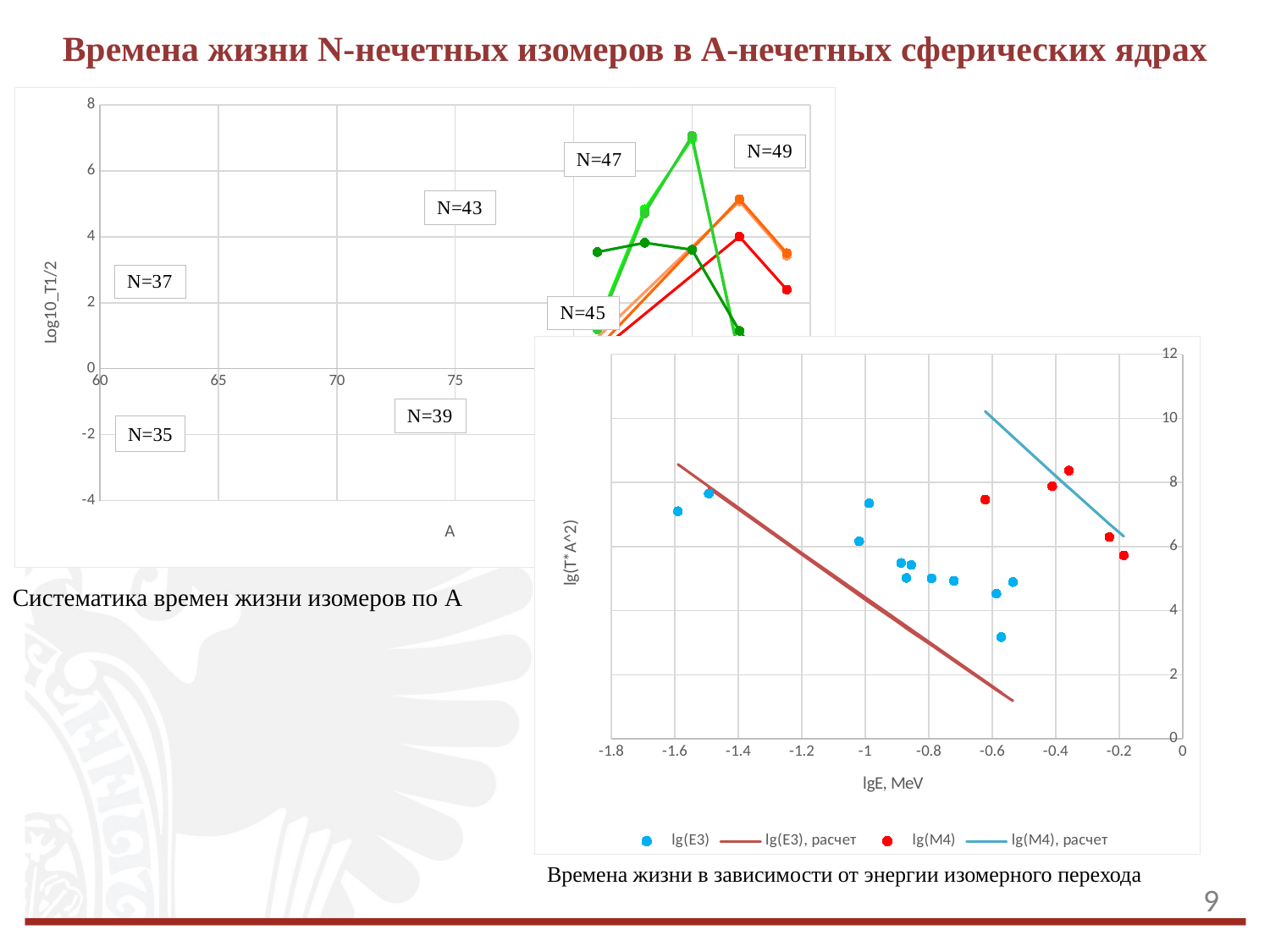
In the bottom-right chart, what is the title of the x axis? lgE, MeV What kind of chart is the top-left chart 'Систематика времен жизни изомеров по A'? line chart In the bottom-right chart, how many red lg(M4) data points are plotted? 5 What kind of chart is the bottom-right chart titled 'Времена жизни в зависимости от энергии изомерного перехода'? scatter chart In the top-left chart, is the highest point of the bright green line greater or less than 6? greater In the bottom-right chart, is the lowest blue lg(E3) point (near lgE = -0.55) greater or less than 4? less In the bottom-right chart, does the 'lg(E3), расчет' line rise or fall as lgE increases? fall In the bottom-right chart, is the leftmost blue lg(E3) point (near lgE = -1.6) greater or less than 6? greater How many series does the legend of the bottom-right chart list? 4 In the top-left chart, what is the label of the y axis? Log10_T1/2 In the bottom-right chart, what is the title of the y axis? lg(T*A^2) In the top-left chart, at what value does the x axis (A) begin? 60